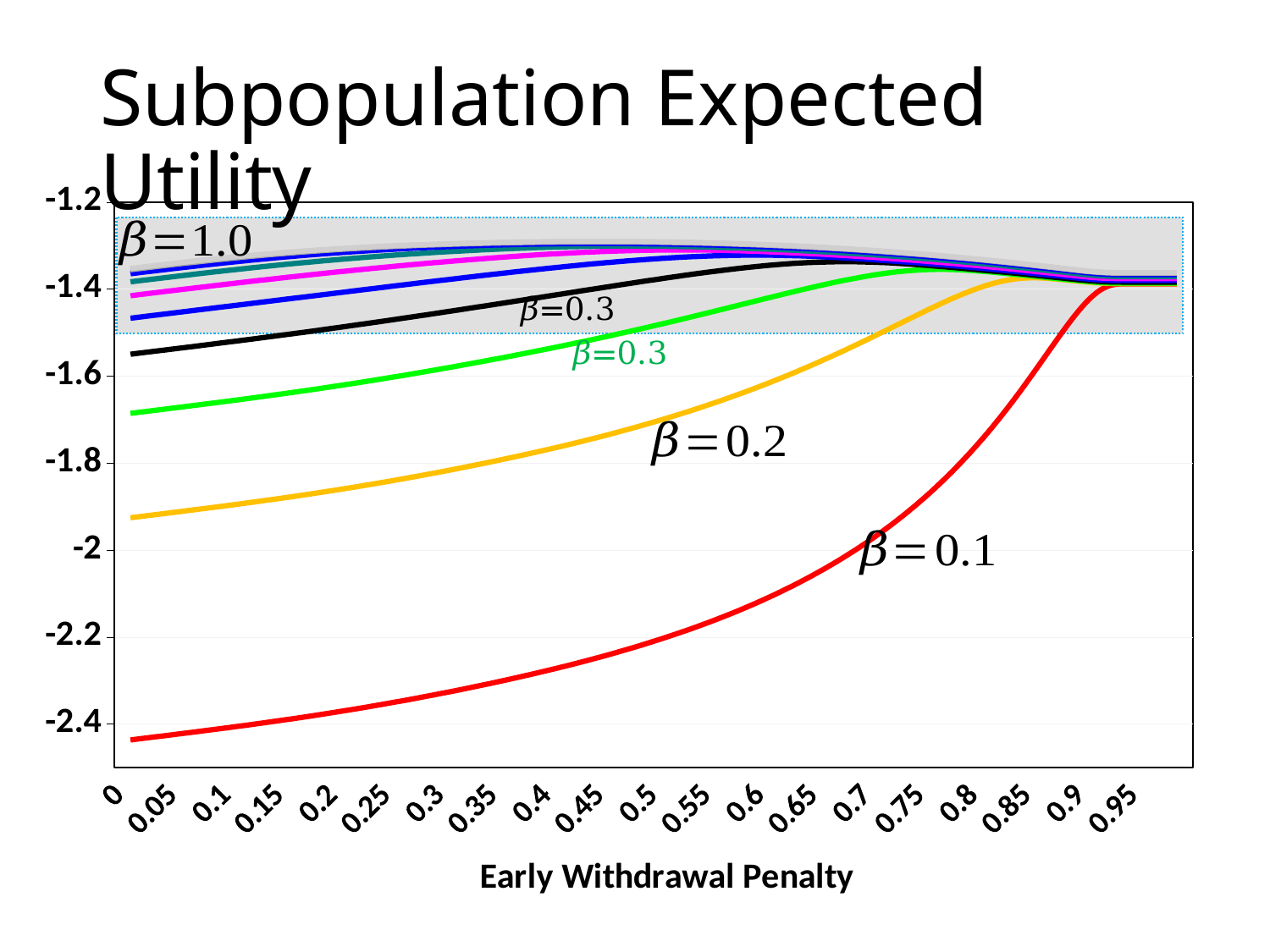
Is the value of the β=1.0 curve at an early withdrawal penalty of 0 greater or less than -1.6? greater How many tick labels are shown on the x axis? 20 What is the lowest value labelled on the y axis? -2.4 What is the title of the chart? Subpopulation Expected Utility Is the value of the β=0.1 curve at an early withdrawal penalty of 0.95 greater or less than -1.6? greater What kind of chart is shown on the slide? line chart Does the β=0.1 curve rise or fall as the early withdrawal penalty increases from 0 to 0.9? rise Which curve has the lowest value at an early withdrawal penalty of 0? β=0.1 What is the label of the x axis? Early Withdrawal Penalty Is the value of the β=0.1 curve at an early withdrawal penalty of 0 greater or less than -2.2? less At an early withdrawal penalty of 0, which curve has the larger value, β=0.2 or β=0.1? β=0.2